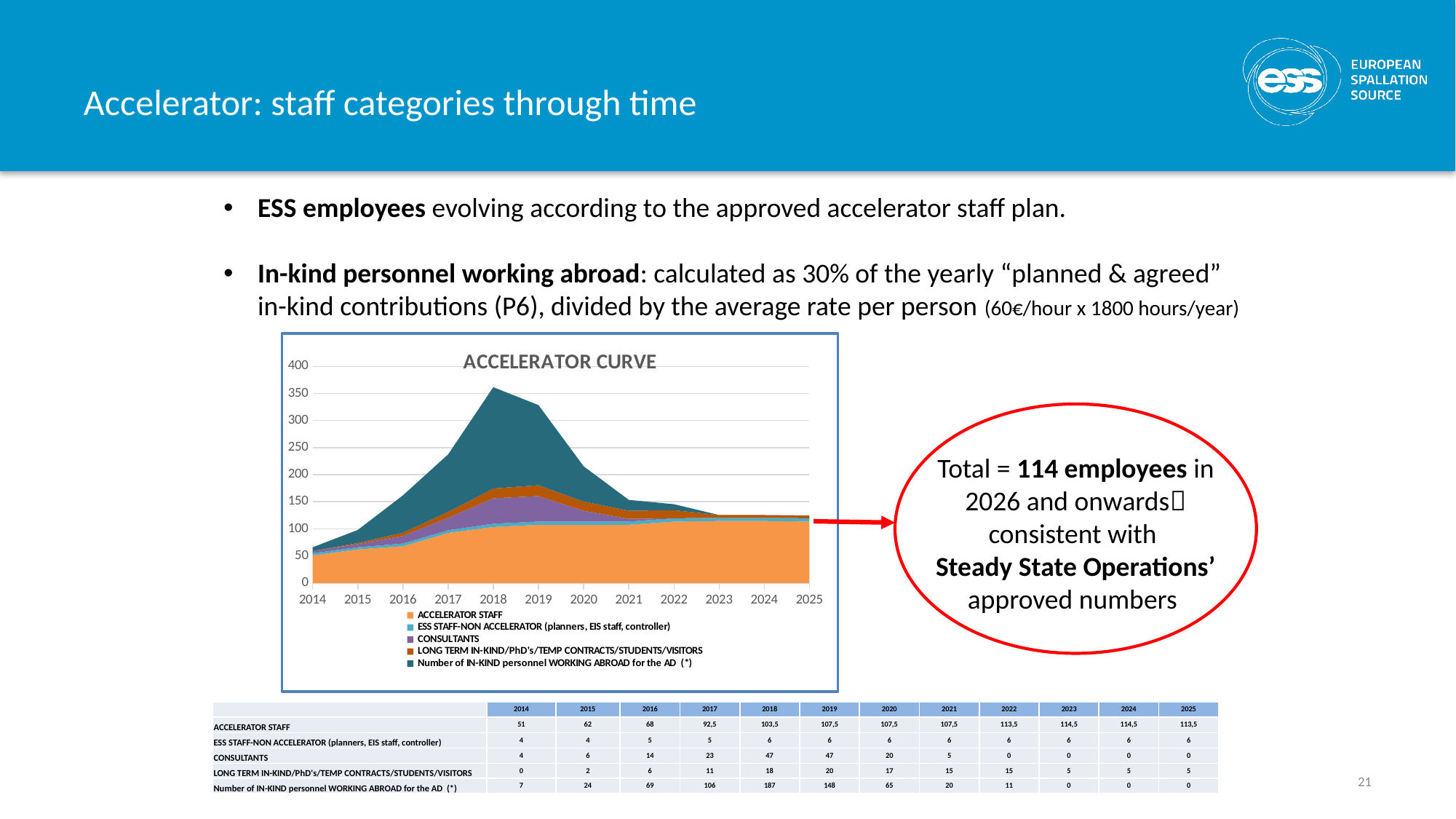
What is the difference between the Number of IN-KIND personnel WORKING ABROAD for the AD in 2018 and in 2019? 39 How many series does the legend of the ACCELERATOR CURVE chart list? 5 Is the total stacked value in 2018 greater or less than 300? greater Does the Number of IN-KIND personnel WORKING ABROAD for the AD rise or fall from 2018 to 2025? fall What is the value for Number of IN-KIND personnel WORKING ABROAD for the AD in 2018? 187 What is the total of all stacked series in 2014? 66 Which is larger in 2016: CONSULTANTS or LONG TERM IN-KIND/PhD's/TEMP CONTRACTS/STUDENTS/VISITORS? CONSULTANTS What is the value for CONSULTANTS in 2020? 20 What kind of chart is the ACCELERATOR CURVE chart? area chart In which year is the Number of IN-KIND personnel WORKING ABROAD for the AD highest? 2018 How many years are shown on the x axis of the ACCELERATOR CURVE chart? 12 What is the value for ACCELERATOR STAFF in 2018? 103,5